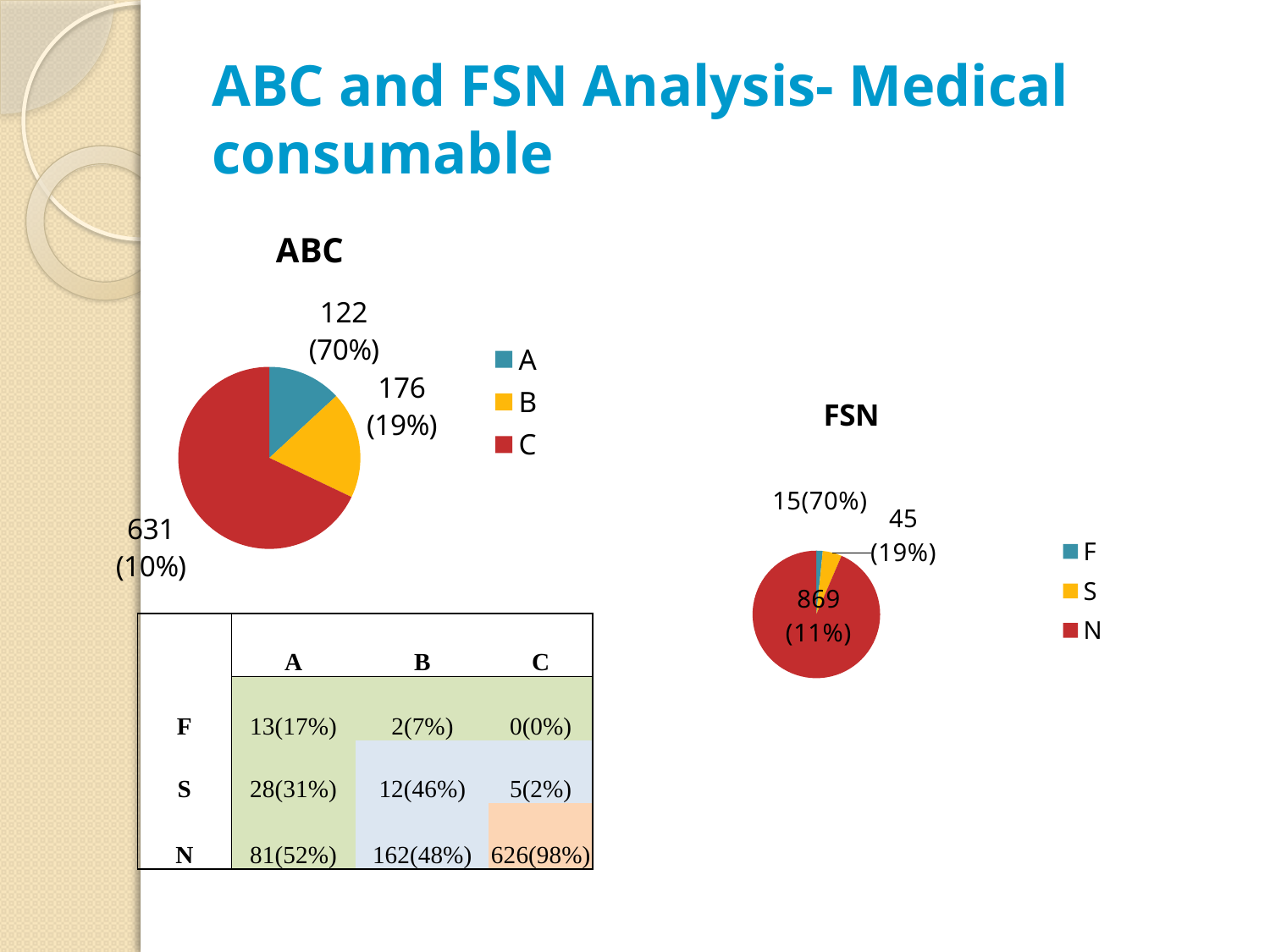
In the ABC pie chart, what percentage is printed next to slice A? 70% In the FSN pie chart, what count is shown for category S? 45 In the ABC pie chart, what is the difference between the counts for C and A? 509 In the FSN pie chart, what count is shown for category N? 869 In the ABC pie chart, what count is shown for category B? 176 In the FSN pie chart, which category has the smallest slice? F How many entries does the legend of the FSN chart list? 3 In the ABC pie chart, which category has the largest slice? C In the ABC pie chart, what count is shown for category C? 631 What type of chart is the ABC chart? Pie chart In the ABC pie chart, what count is shown for category A? 122 In the FSN pie chart, what is the difference between the counts for N and S? 824